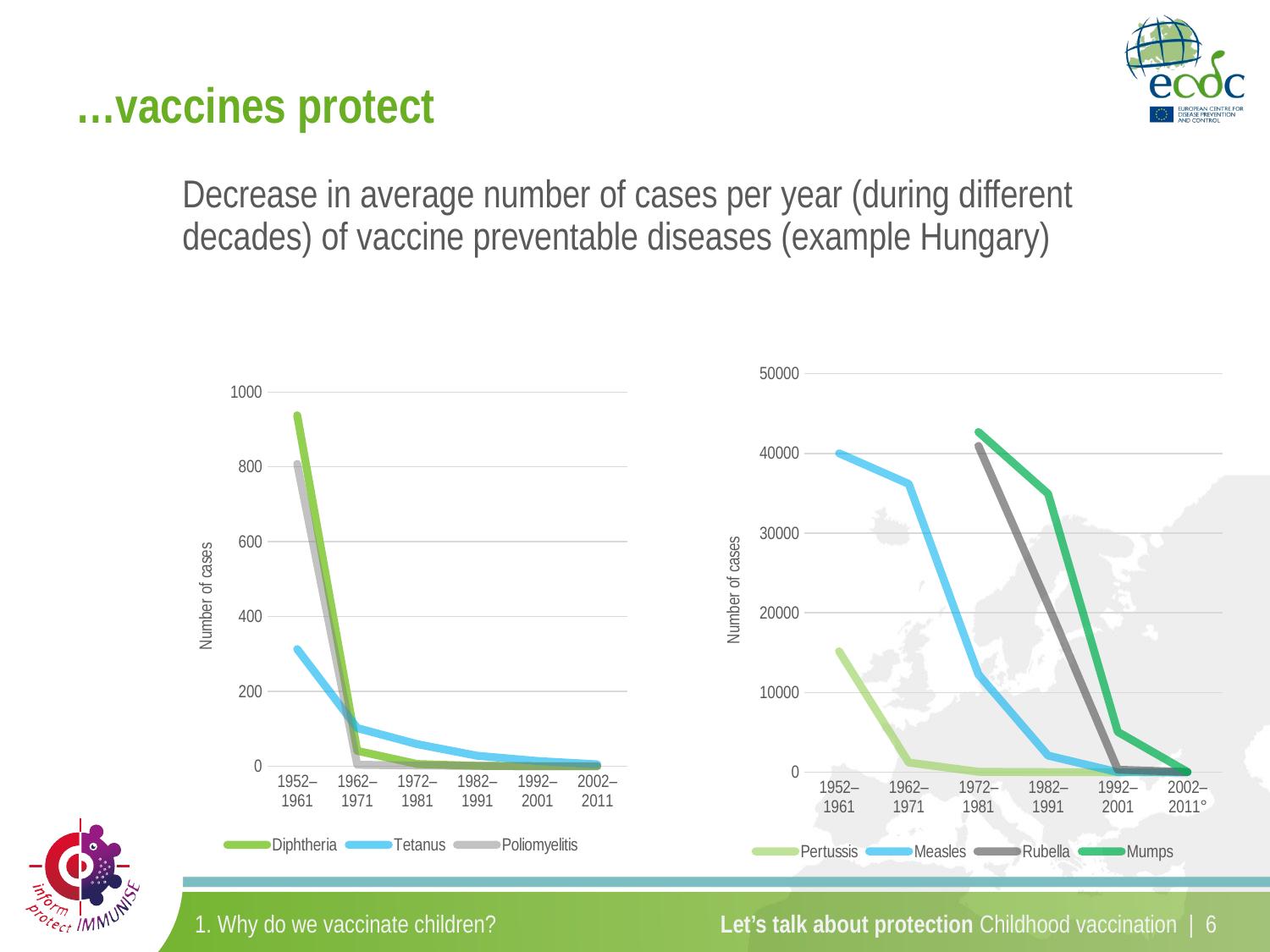
In the right chart, which is larger in 1952–1961, Measles or Pertussis? Measles How many series does the legend of the left chart list? 3 How many series does the legend of the right chart list? 4 In the left chart, is the value for Tetanus in 1952–1961 greater or less than 400? less In the right chart, do the Measles values rise or fall from 1952–1961 to 2002–2011°? fall What is the y-axis label of the right chart? Number of cases In the right chart, is the value for Measles in 1952–1961 greater or less than 30000? greater In the left chart, which series has the lowest value in 1952–1961? Tetanus How many decade categories are shown on the x axis of the right chart? 6 In the left chart, which series has the highest value in 1952–1961? Diphtheria What kind of chart is the left chart? line chart In the left chart, is the value for Diphtheria in 1952–1961 greater or less than 800? greater